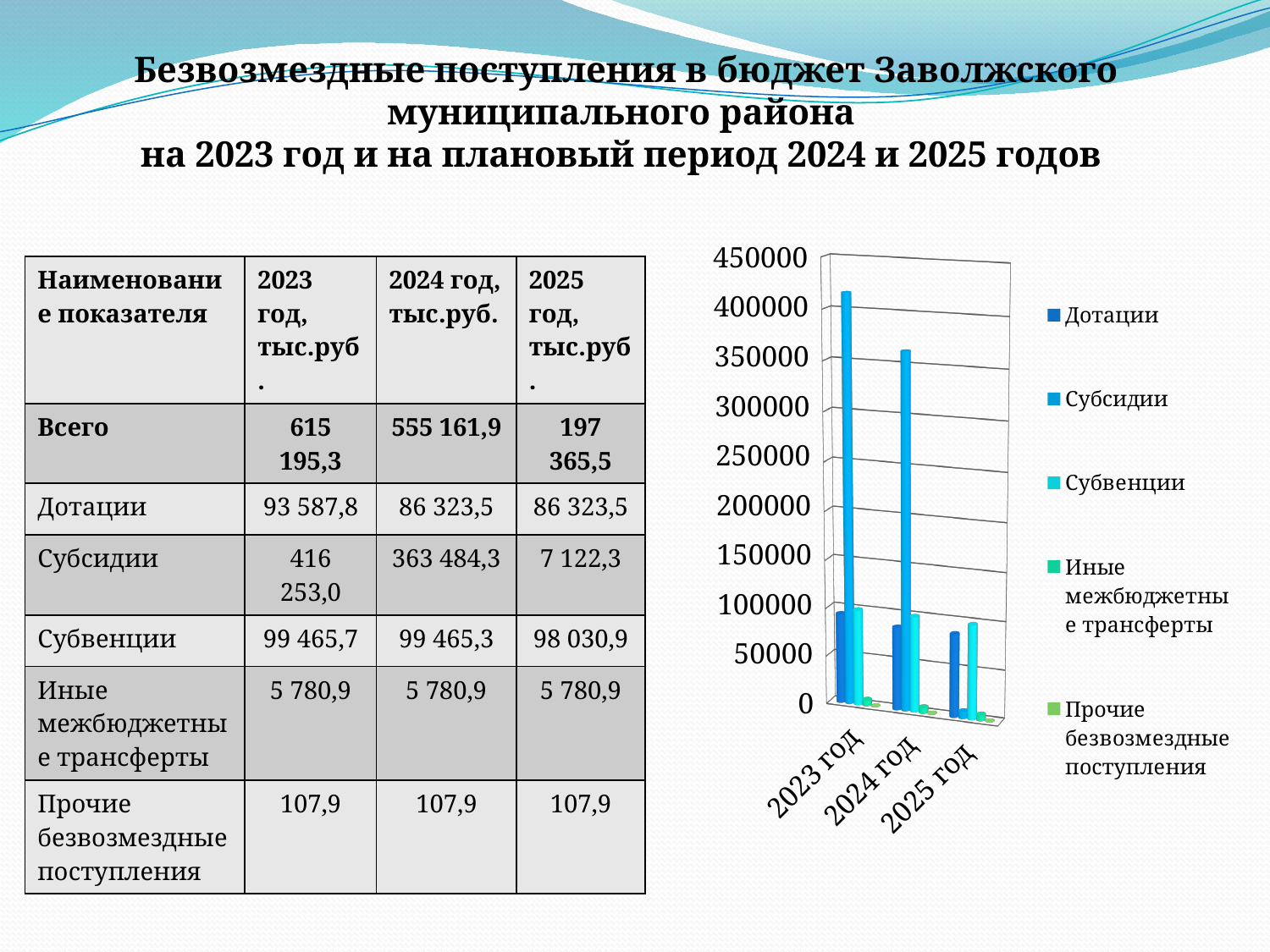
Which year has the shortest Субсидии bar in the chart? 2025 год According to the slide, what is the value of Субсидии for 2024 год? 363 484,3 How many year categories are shown on the x axis of the chart? 3 How many series does the chart legend list? 5 What is the highest value shown on the chart's vertical axis? 450000 Is the Дотации bar for 2023 год greater or less than 150000? less Do the Субсидии values rise or fall from 2023 год to 2025 год? fall Which year has the tallest Субсидии bar in the chart? 2023 год Is the Субсидии bar for 2025 год greater or less than 50000? less In 2024 год, which is larger in the chart: Субсидии or Дотации? Субсидии Is the Субсидии bar for 2023 год greater or less than 400000? greater What kind of chart is shown on the slide? bar chart